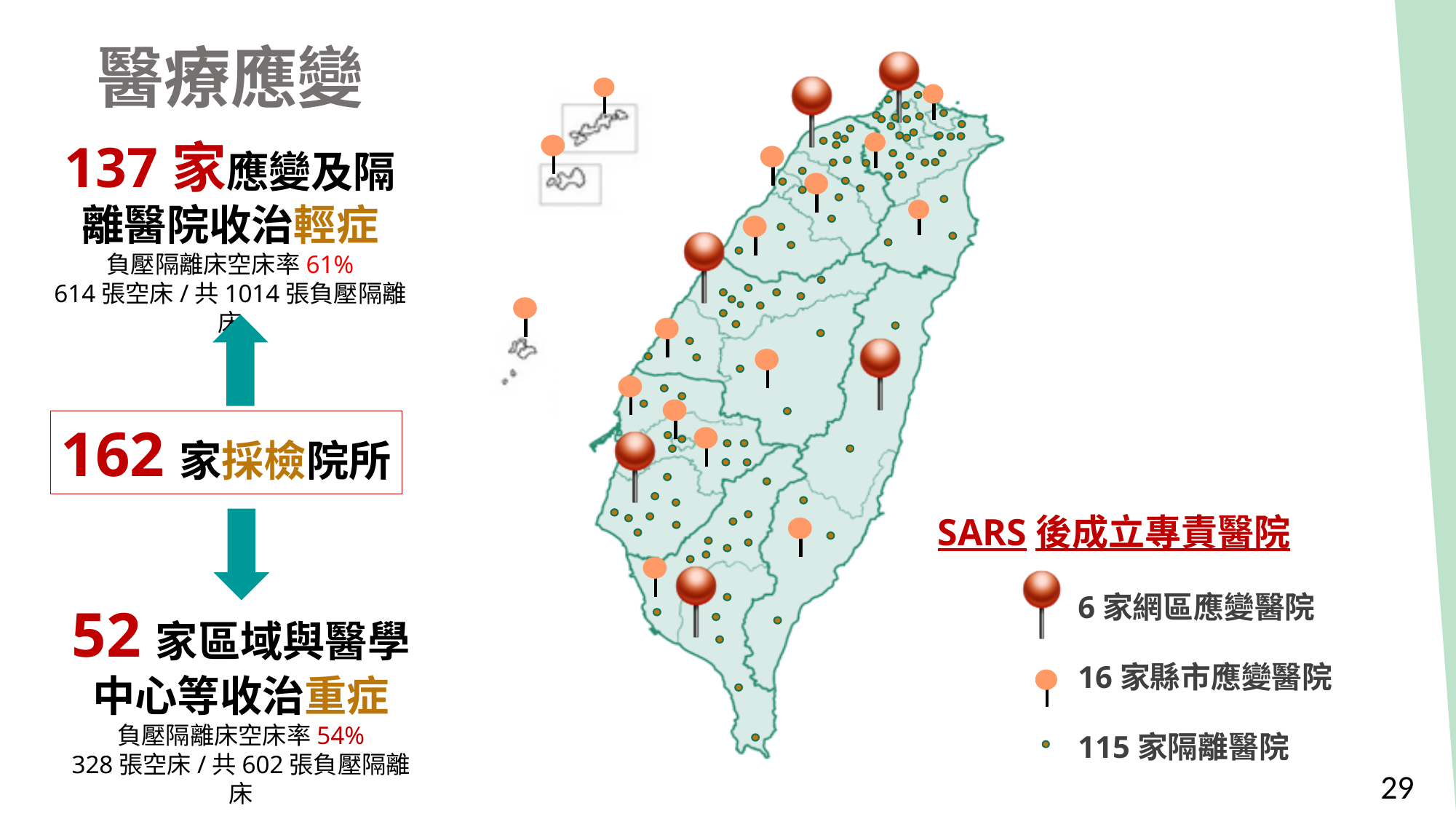
Which hospital category in the map legend has the smallest number? 網區應變醫院 Which hospital category in the map legend has the largest number? 隔離醫院 What is the difference between the number of 縣市應變醫院 and 網區應變醫院 in the legend? 10 According to the map legend, how many 網區應變醫院 are there? 6 家 According to the map legend, how many 隔離醫院 are there? 115 家 According to the map legend, how many 縣市應變醫院 are there? 16 家 What is the total number of hospitals across the three categories in the map legend? 137 How many categories of hospitals does the map legend list? 3 Which is larger in the map legend: the number of 縣市應變醫院 or the number of 網區應變醫院? 縣市應變醫院 How many more 隔離醫院 are there than 縣市應變醫院 according to the legend? 99 What kind of chart is shown on the slide? A map chart (map of Taiwan with location markers) What is the heading above the map legend? SARS 後成立專責醫院